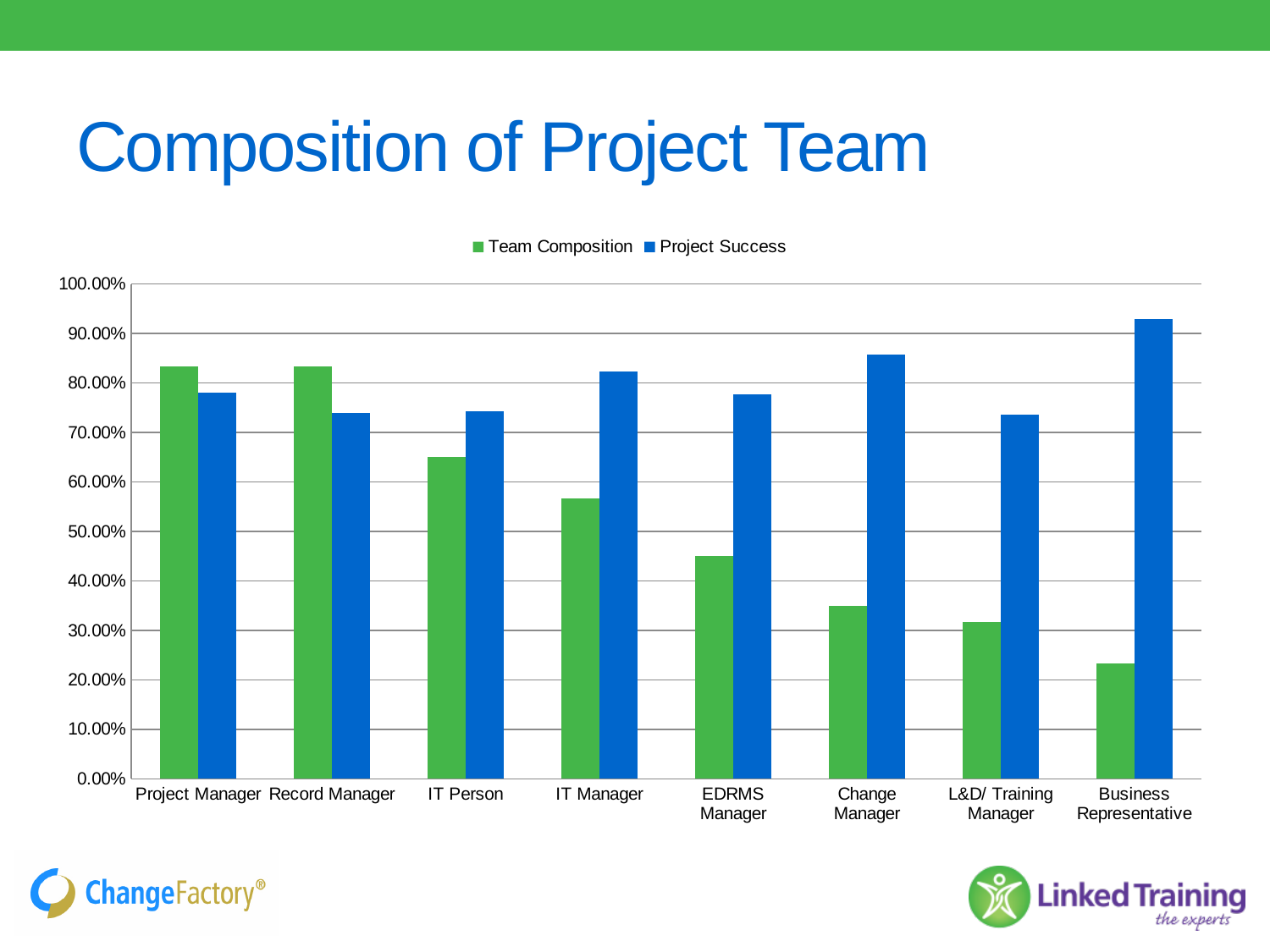
For IT Manager, which is larger: Team Composition or Project Success? Project Success Is the Team Composition value for Business Representative greater or less than 30.00%? less Which category has the lowest Team Composition value? Business Representative What kind of chart is shown on the slide? Bar chart Do the Team Composition values rise or fall moving left to right along the x axis? fall Is the Team Composition value for EDRMS Manager greater or less than 50.00%? less Is the Project Success value for Business Representative greater or less than 90.00%? greater What colour represents the Project Success series in the legend? Blue Which category has the highest Project Success value? Business Representative How many categories are shown on the x axis? 8 How many series does the legend list? 2